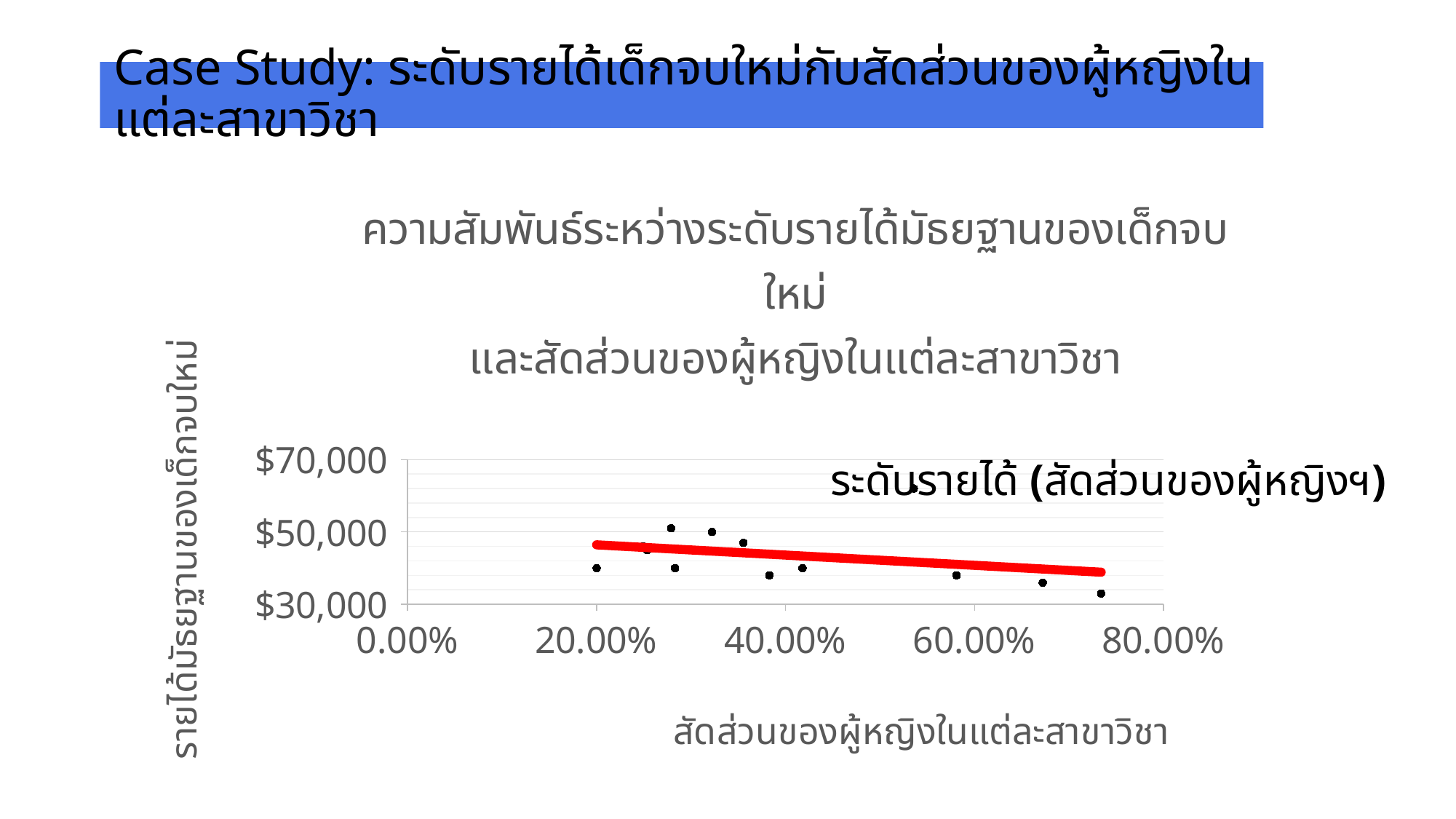
As the share of women in a field (x axis) increases, does the median income of new graduates tend to rise or fall? fall Is the income value for the point at roughly 74% women greater or less than $50,000? less What colour is the trend line on the chart? red What kind of chart is shown on the slide? scatter chart Is the income value for the point at roughly 58% women greater or less than $50,000? less Is the income value for the point at roughly 20% women greater or less than $30,000? greater Does the red trend line slope upward or downward from left to right? downward